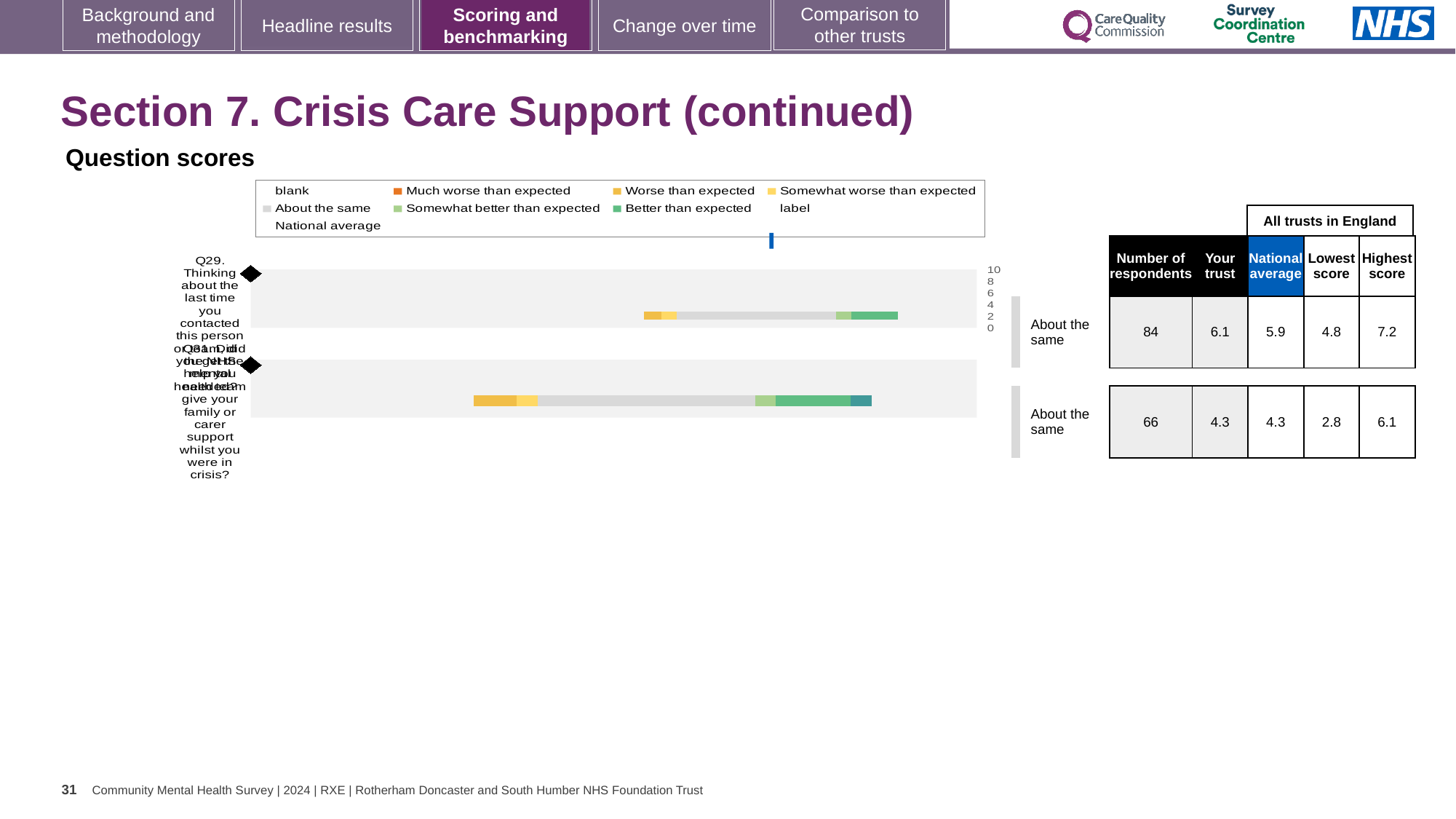
In the table beside the chart, what is the 'Your trust' score for Q29? 6.1 What benchmark category is shown next to the chart for Q29? About the same By how much does the trust's score for Q29 exceed the national average for Q29? 0.2 Which question has the higher 'Your trust' score, Q29 or Q31? Q29 How many questions (rows) are plotted in the question scores chart? 2 What is the difference between the highest and lowest scores for Q31? 3.3 What is the highest score among all trusts in England for Q31? 6.1 What kind of chart is used to show the question scores on this slide? bar chart How many respondents answered Q29 according to the table beside the chart? 84 What is the lowest score among all trusts in England for Q29? 4.8 What colour does the legend use for 'Better than expected'? green In the table beside the chart, what is the national average for Q31? 4.3